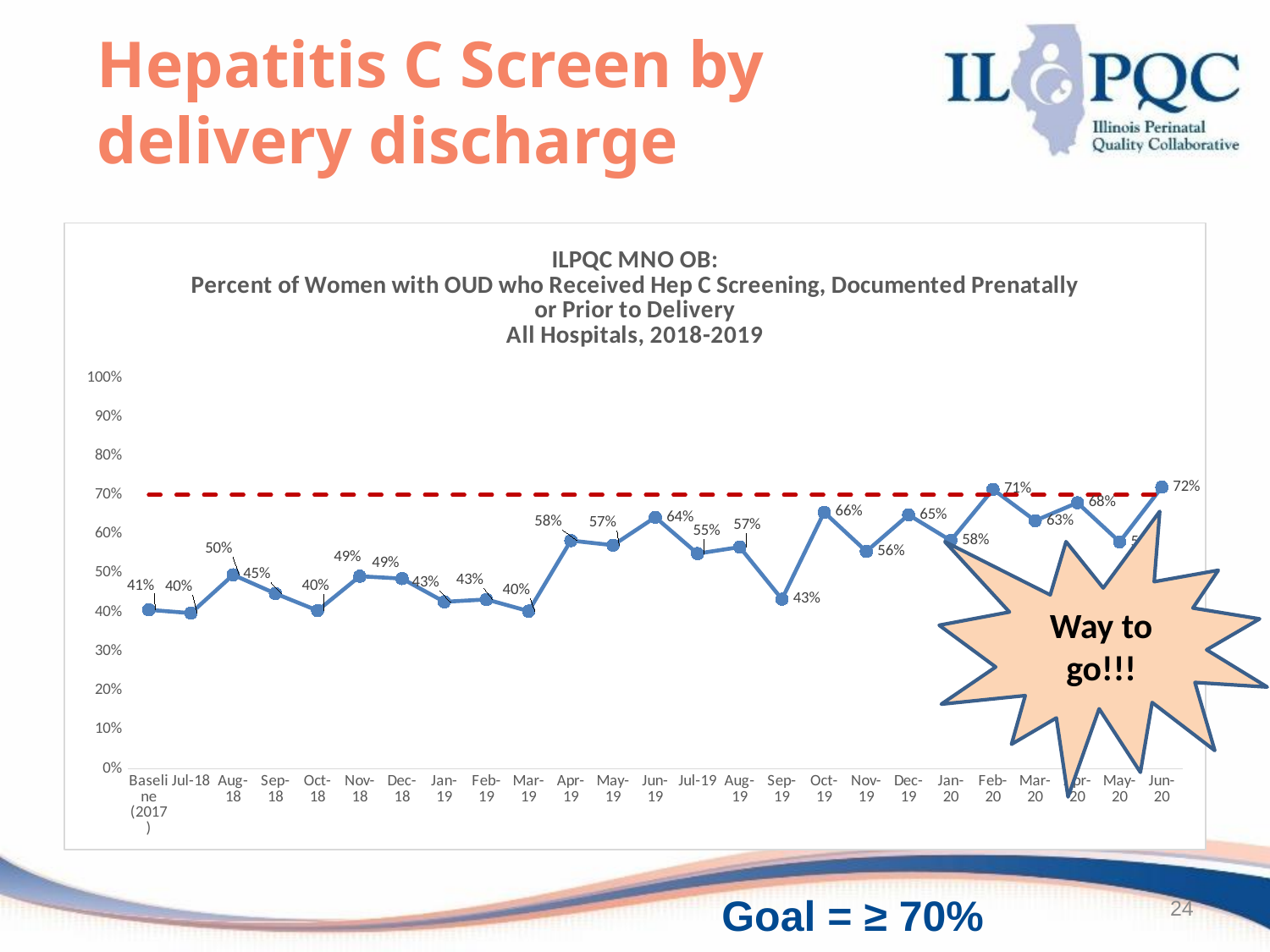
What is the value for Aug-18? 50% Which is larger, the value for Jun-19 or the value for Jul-19? Jun-19 What kind of chart is shown? line chart What is the value for Feb-20? 71% At what percentage is the dashed red goal line drawn? 70% What is the difference between the Feb-20 value and the Mar-20 value? 8 percentage points Is the value for Sep-19 greater or less than 50%? less What is the value for Oct-19? 66% Which month has the highest value? Jun-20 What is the difference between the Jun-20 value and the Baseline (2017) value? 31 percentage points What is the value for Dec-19? 65% What is the value for Jun-20? 72%